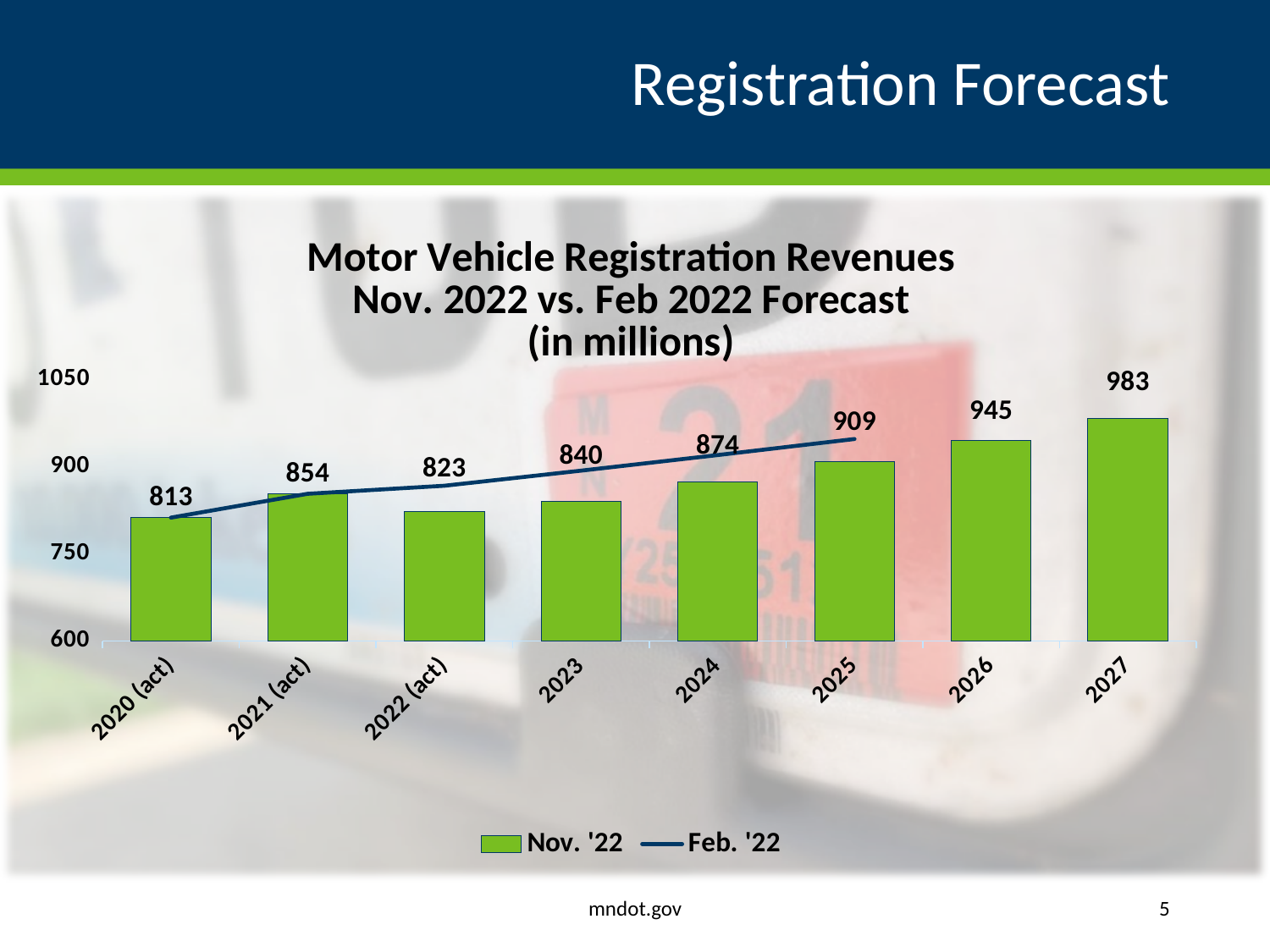
Which category has the lowest Nov. '22 value? 2020 (act) What is the Nov. '22 value for 2022 (act)? 823 What is the Nov. '22 value for 2027? 983 What is the difference between the Nov. '22 values for 2027 and 2020 (act)? 170 Is the Feb. '22 line value for 2025 greater or less than 900? greater How many series does the legend list? 2 What kind of chart is used for the Nov. '22 series? bar chart Which category has the highest Nov. '22 value? 2027 Do the Nov. '22 values rise or fall from 2022 (act) to 2027? rise Which is larger, the Nov. '22 value for 2021 (act) or for 2022 (act)? 2021 (act) What is the Nov. '22 value for 2024? 874 How many categories are shown on the x axis? 8